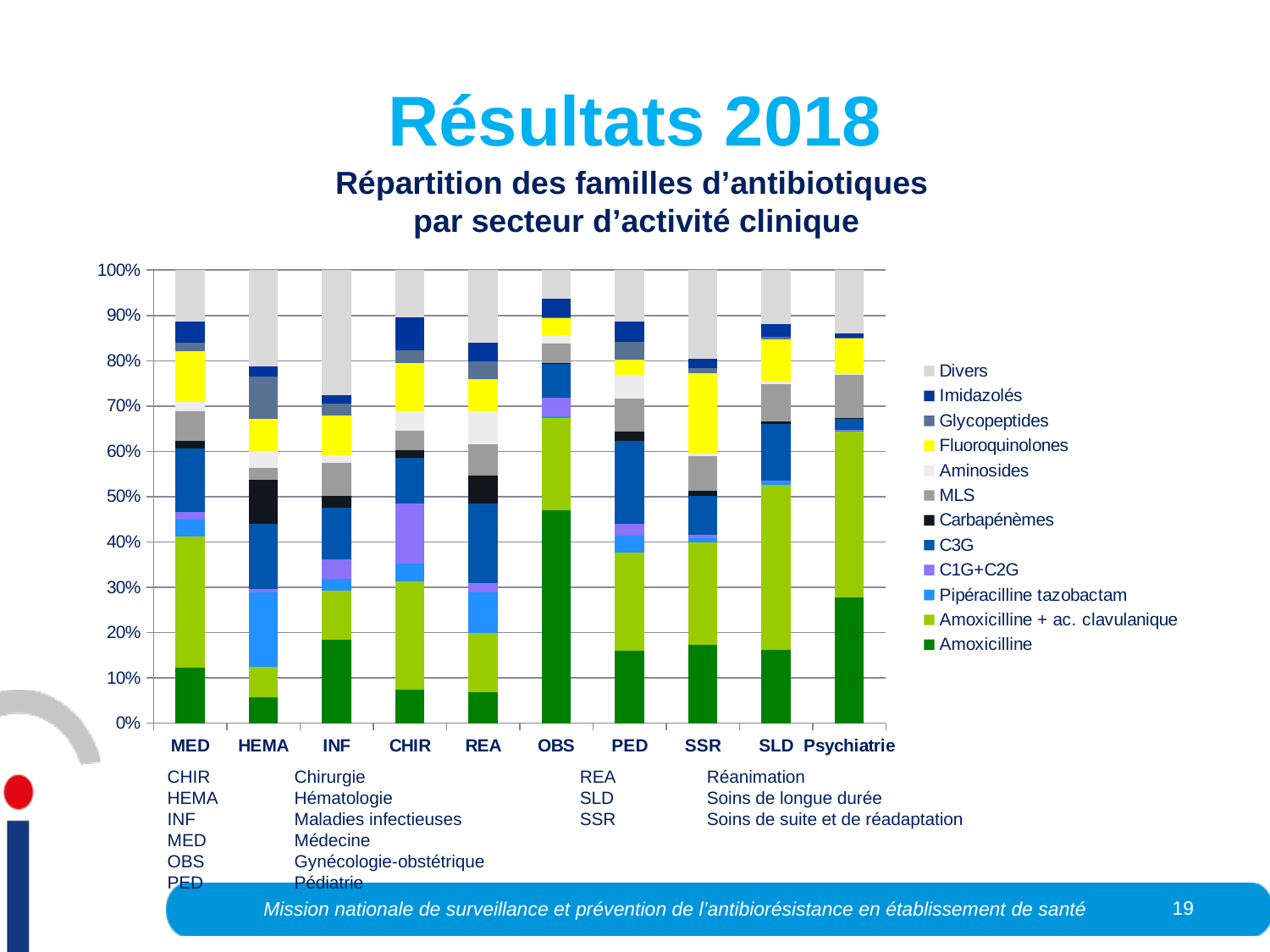
Which sector has the largest C1G+C2G share? CHIR Is the Amoxicilline share for HEMA greater or less than 10%? less Is the Amoxicilline share for OBS greater or less than 40%? greater What kind of chart is shown on the slide? Stacked bar chart Which sector has the largest Pipéracilline tazobactam share? HEMA How many antibiotic families does the chart legend list? 12 How many clinical sectors (categories) are shown on the x axis of the chart? 10 Which sector has the largest Amoxicilline share? OBS Which is larger, the Amoxicilline share for OBS or for MED? OBS Which sector has the smallest Amoxicilline + ac. clavulanique share? HEMA Which sector has the smallest Divers share? OBS